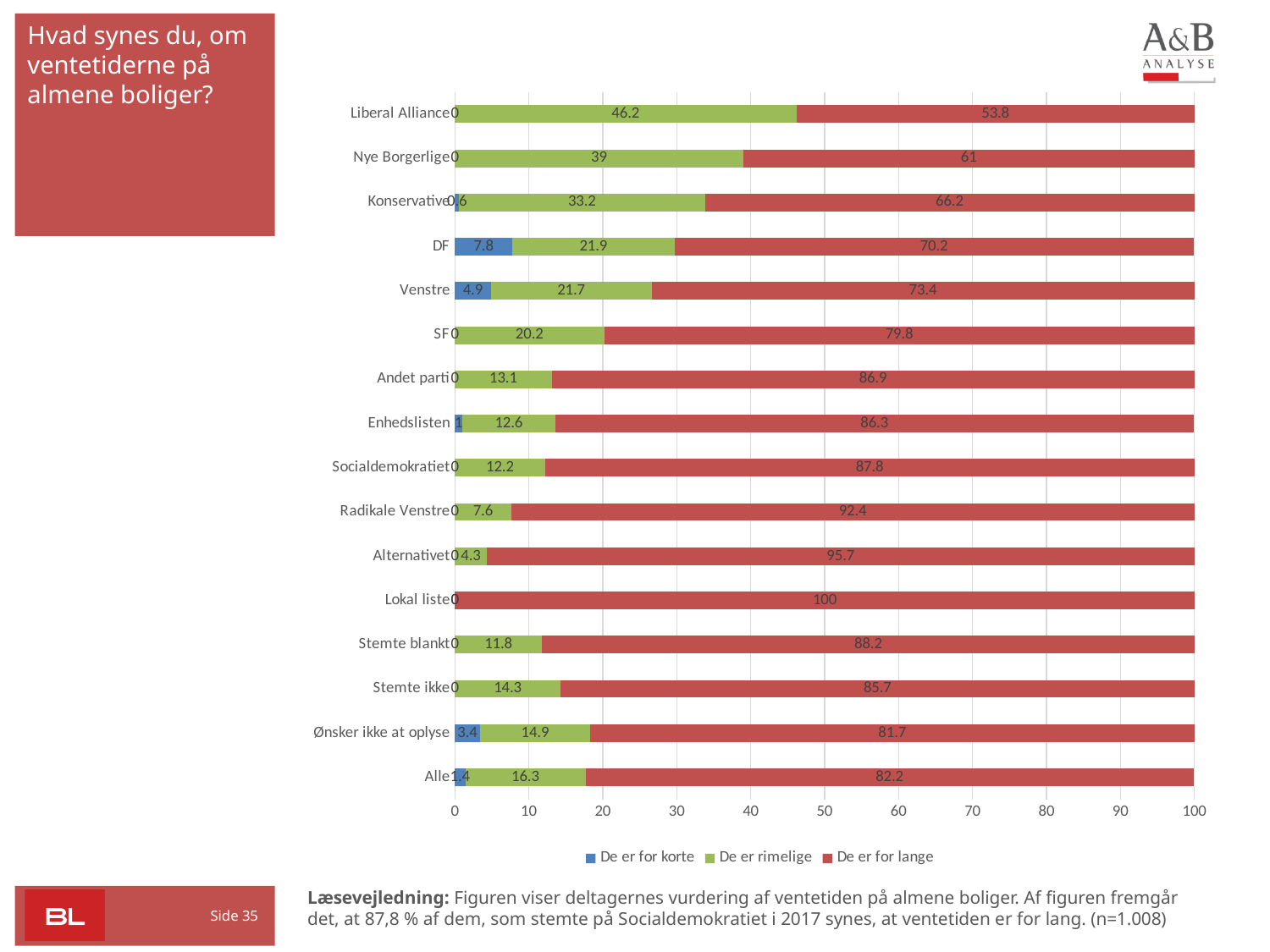
How many series does the legend list? 3 What is the value of 'De er for korte' for DF? 7.8 Which series is shown in red? De er for lange Which category has the lowest value for 'De er for lange'? Liberal Alliance What kind of chart is shown on the slide? Stacked bar chart What is the difference between the 'De er for lange' values for Venstre and DF? 3.2 How many categories are shown on the vertical axis? 16 Which category has the highest value for 'De er for lange'? Lokal liste What is the value of 'De er for lange' for Socialdemokratiet? 87.8 What is the value of 'De er rimelige' for Liberal Alliance? 46.2 Which is larger: the 'De er rimelige' value for Nye Borgerlige or for Konservative? Nye Borgerlige What is the value of 'De er for korte' for Alle? 1.4